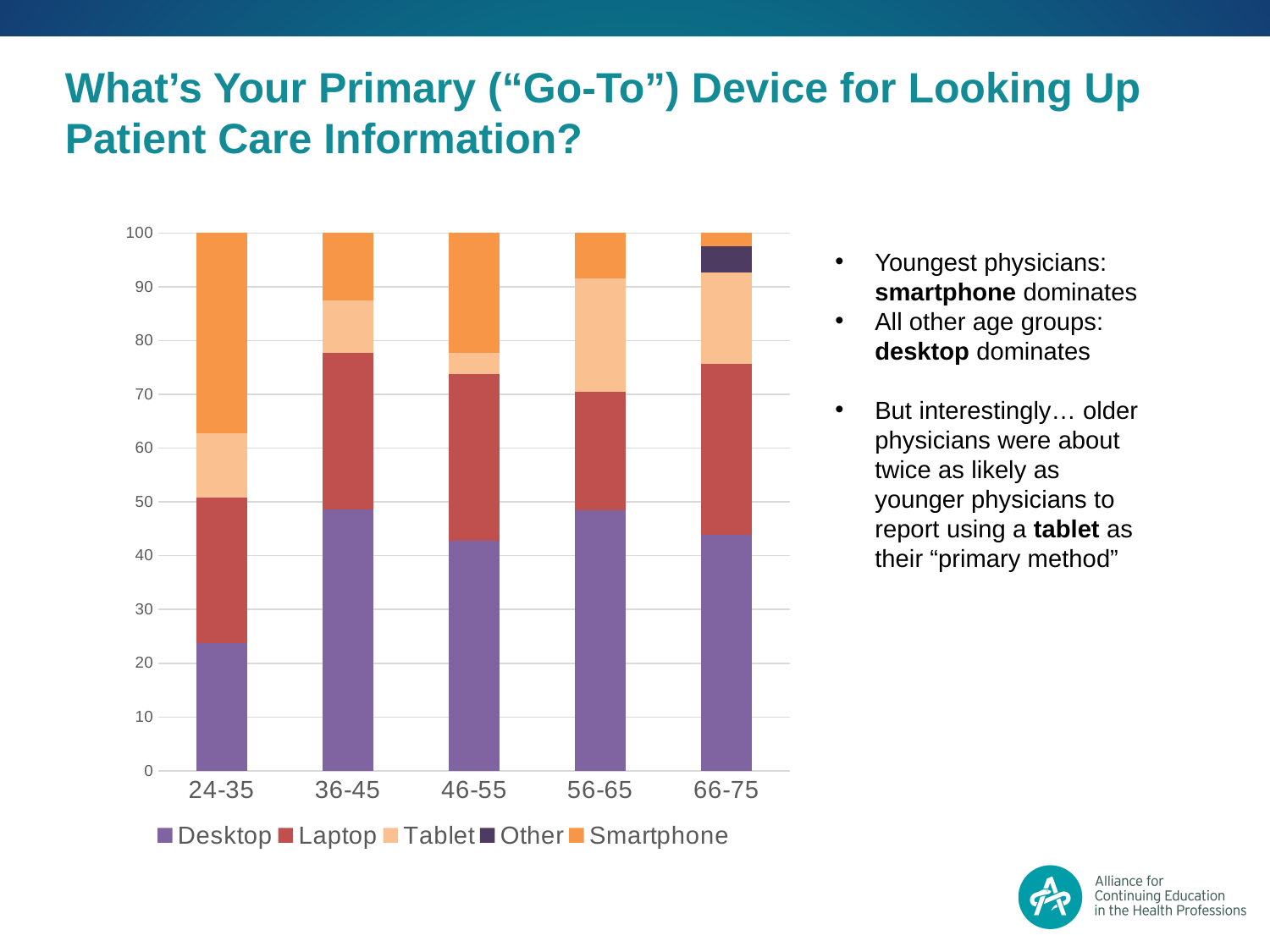
Which age group has the largest Smartphone segment? 24-35 Is the Desktop value for the 46-55 age group greater or less than 50? less How many age groups are shown on the x axis of the chart? 5 What type of chart is shown on the slide? Stacked bar chart What is the total of the stacked bar for the 24-35 age group? 100 Which age group is the only one with an 'Other' segment in its bar? 66-75 How many series does the chart legend list? 5 Which age group has the smallest Desktop segment? 24-35 Which age group has the larger Desktop segment, 24-35 or 36-45? 36-45 Is the Desktop value for the 24-35 age group greater or less than 30? less Which age group has the larger Tablet segment, 24-35 or 56-65? 56-65 Is the Desktop value for the 36-45 age group greater or less than 40? greater